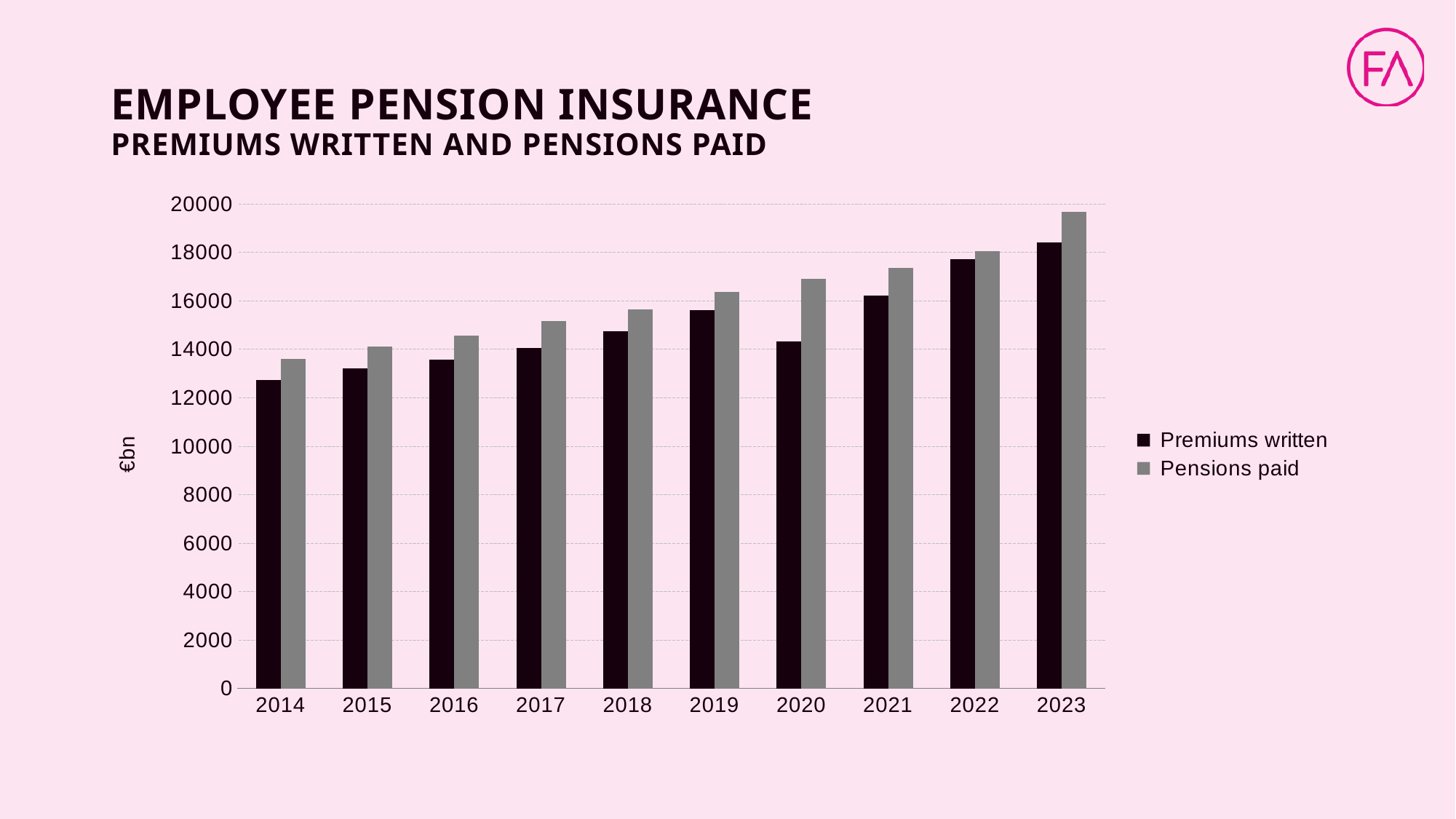
Is the value for Pensions paid in 2023 greater or less than 18000? greater What unit is shown on the y axis label? €bn Do the values for Pensions paid rise or fall from 2014 to 2023? rise How many series does the legend list? 2 Is the value for Pensions paid in 2020 greater or less than 16000? greater Is the value for Premiums written in 2014 greater or less than 14000? less In which year is the value for Premiums written lowest? 2014 What kind of chart is shown on the slide? bar chart For Premiums written, which year has the larger value: 2019 or 2020? 2019 In 2020, which is larger: Premiums written or Pensions paid? Pensions paid How many years are shown on the x axis? 10 In which year is the value for Pensions paid highest? 2023